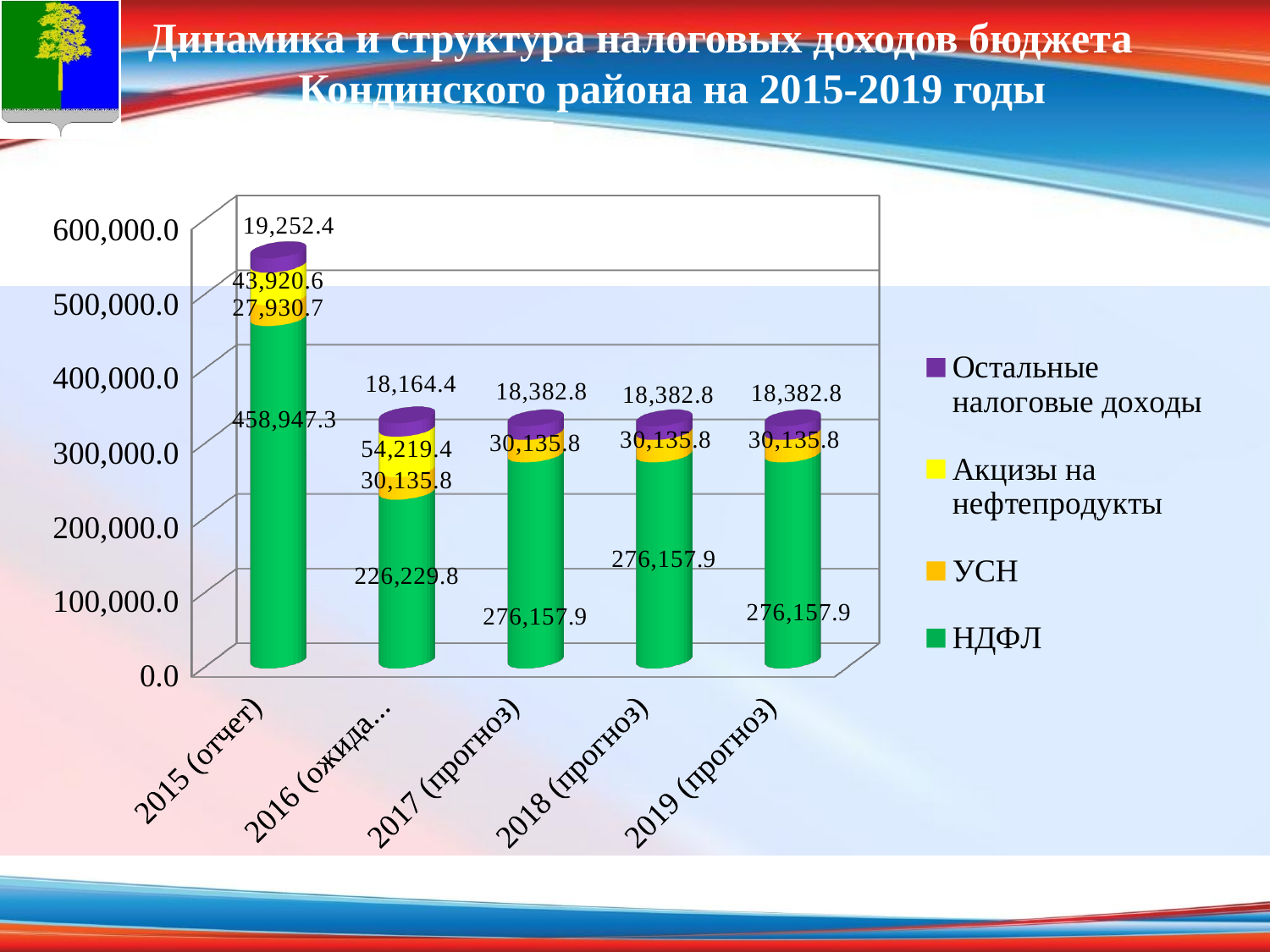
In which year is НДФЛ the highest? 2015 (отчет) What is the value of НДФЛ for 2016? 226,229.8 In which year is НДФЛ the lowest? 2016 What is the value of Остальные налоговые доходы for 2018 (прогноз)? 18,382.8 Which is larger: Акцизы на нефтепродукты in 2015 or in 2016? 2016 What is the total of the stacked bar for 2015 (отчет)? 550,051.0 How many series does the legend list? 4 What is the value of Акцизы на нефтепродукты for 2016? 54,219.4 What is the difference between НДФЛ in 2015 and НДФЛ in 2016? 232,717.5 What is the value of Остальные налоговые доходы for 2015 (отчет)? 19,252.4 What is the value of НДФЛ for 2015 (отчет)? 458,947.3 How many years (categories) are shown on the x axis? 5